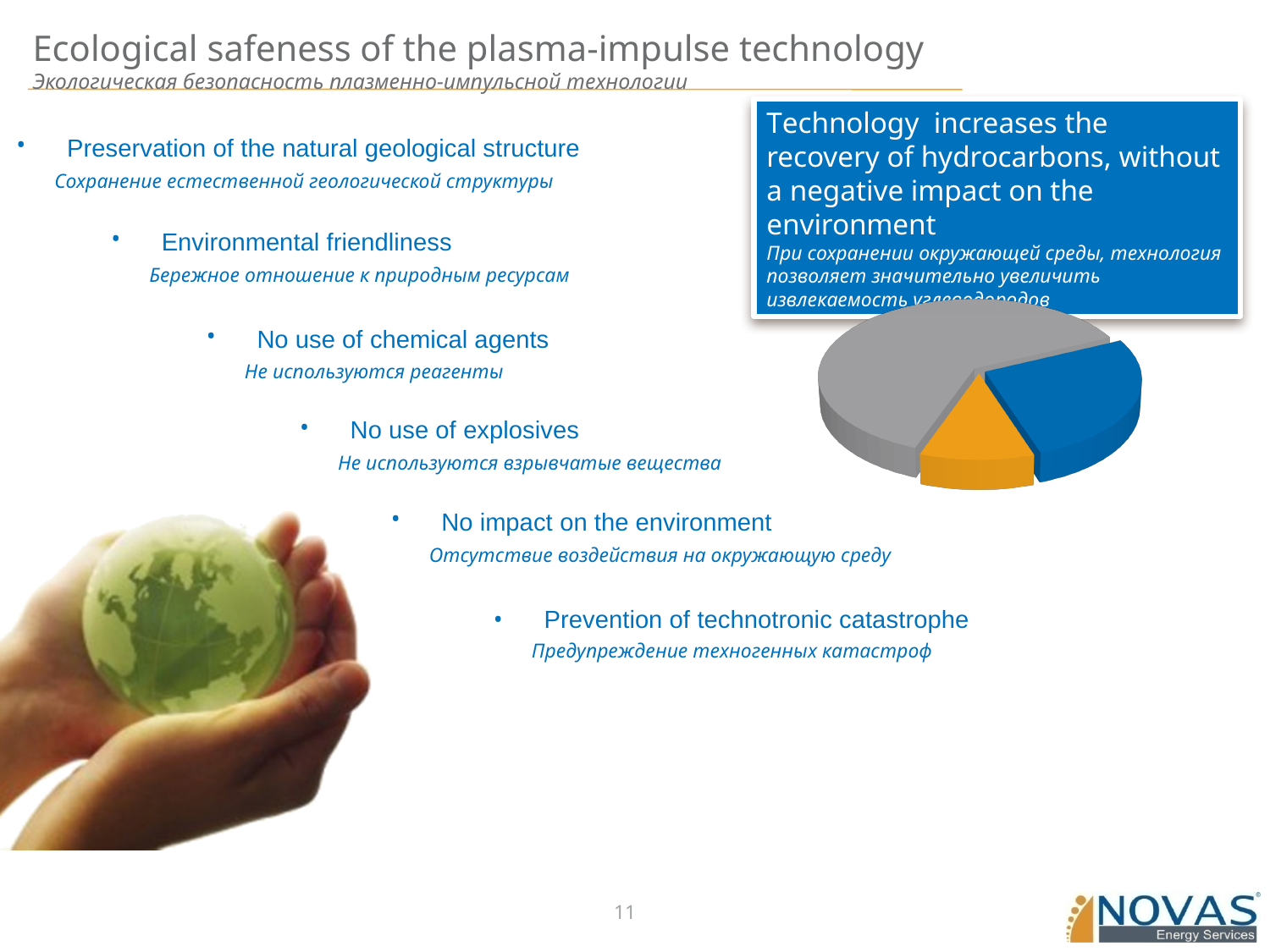
In the pie chart, which is larger, the blue slice or the orange slice? the blue slice In the pie chart, which is larger, the gray slice or the blue slice? the gray slice Which slice of the pie chart is the largest? the gray slice What kind of chart is shown on the right side of the slide? pie chart Which slice of the pie chart is the smallest? the orange slice Does the pie chart on the slide show any data labels with values? No How many slices does the pie chart on the slide have? 3 Does the pie chart on the slide have a legend? No